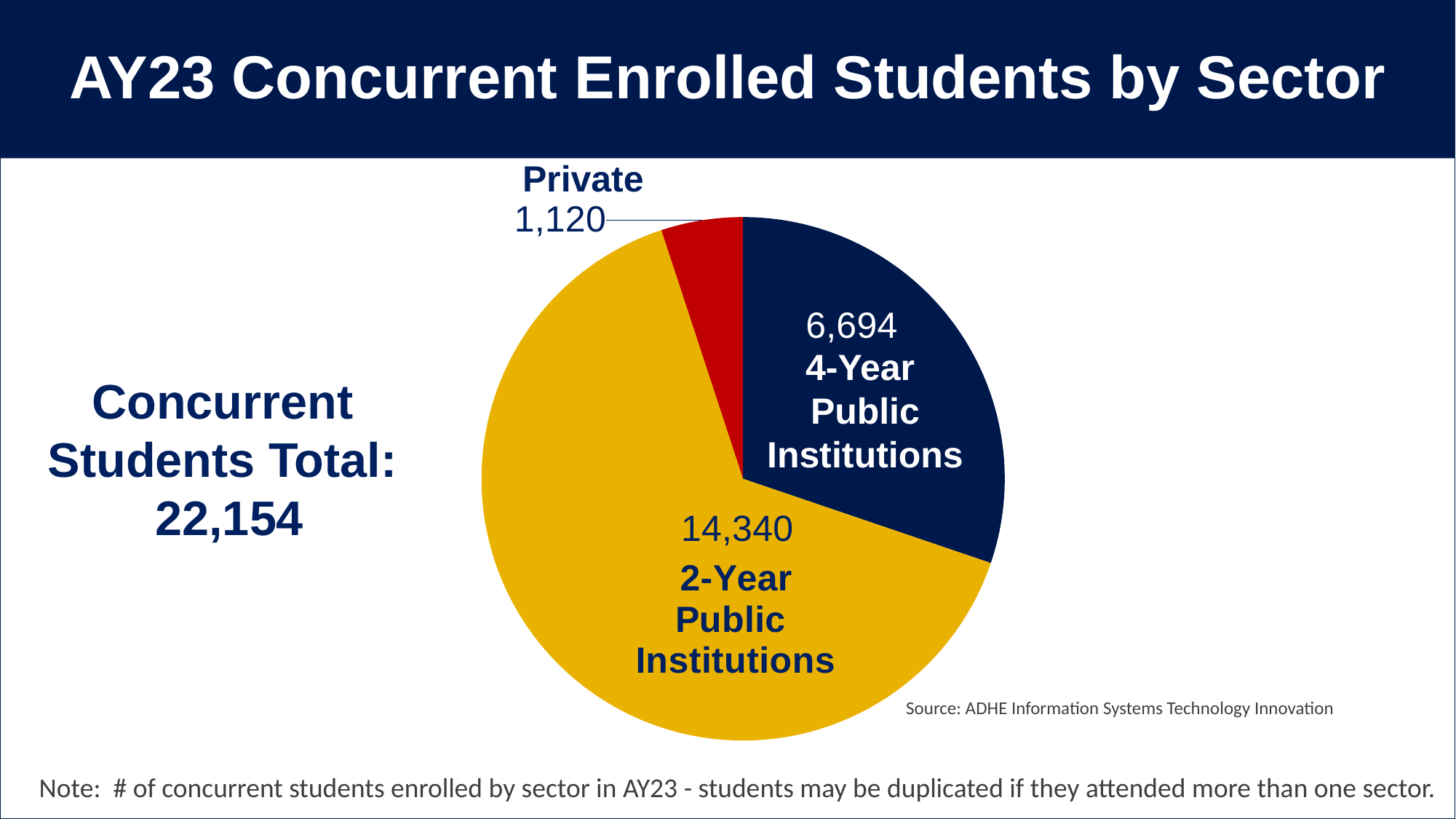
What type of chart is shown on the slide? Pie chart Which sector has the smallest number of concurrent enrolled students? Private How many concurrent enrolled students are in the Private sector? 1,120 What is the total number of concurrent students shown on the slide? 22,154 How many concurrent enrolled students are at 4-Year Public Institutions? 6,694 What colour is the slice for 2-Year Public Institutions? Yellow How many sectors are shown in the pie chart? 3 What is the difference between the number of students at 4-Year Public Institutions and the Private sector? 5,574 Which has more concurrent enrolled students: 4-Year Public Institutions or Private? 4-Year Public Institutions How many concurrent enrolled students are at 2-Year Public Institutions? 14,340 Which sector has the largest number of concurrent enrolled students? 2-Year Public Institutions What is the difference between the number of students at 2-Year Public Institutions and 4-Year Public Institutions? 7,646